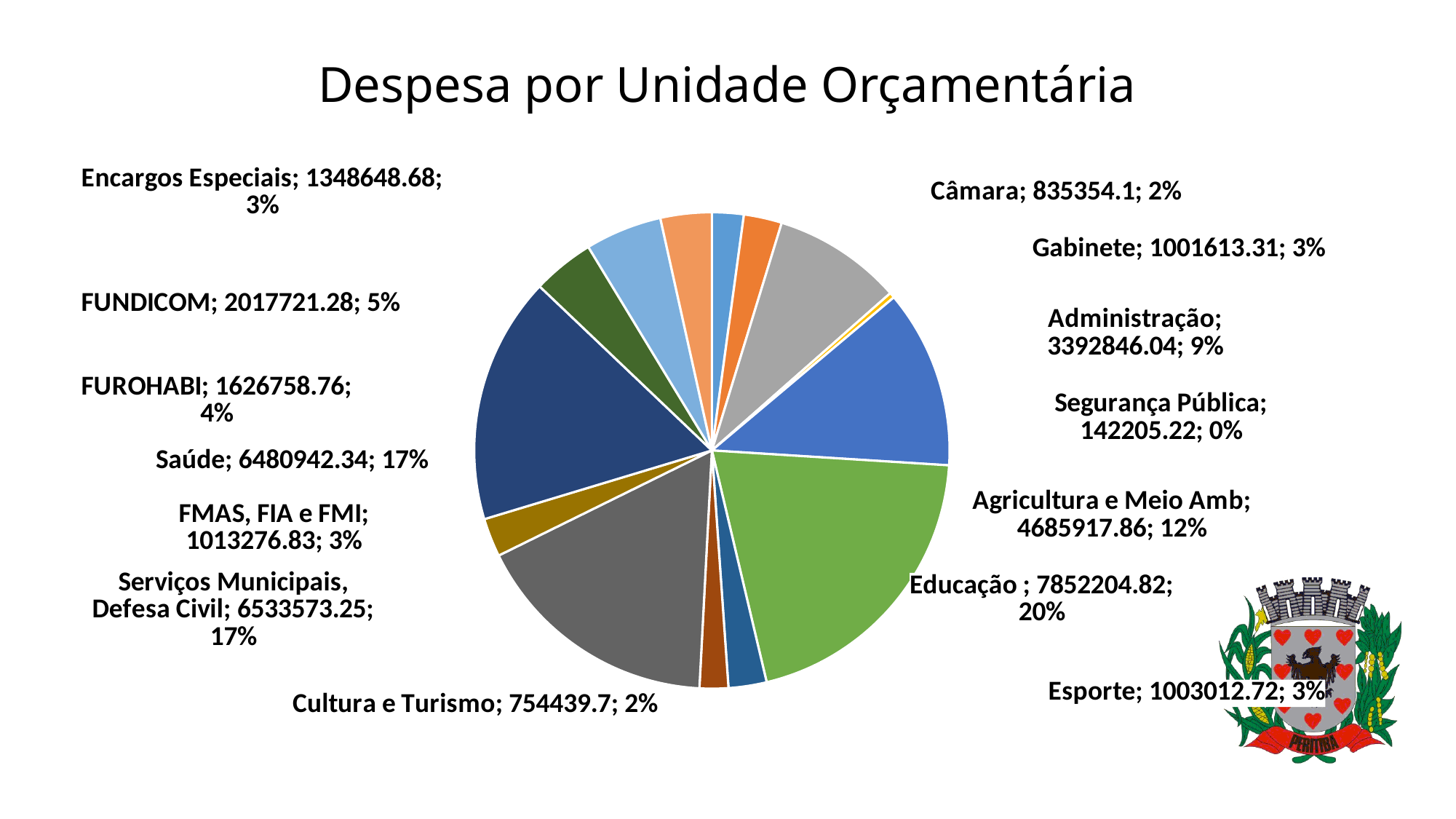
What is the value shown for Educação? 7852204.82 What kind of chart is shown on the slide? pie chart What is the value shown for Administração? 3392846.04 Which is larger, the value for Administração or the value for Agricultura e Meio Amb? Agricultura e Meio Amb What is the title of the chart? Despesa por Unidade Orçamentária What is the value shown for Segurança Pública? 142205.22 How many categories (slices) does the pie chart have? 14 Which category has the largest share of the pie? Educação Which category has the smallest value? Segurança Pública What is the difference between the values for Educação and Saúde? 1371262.48 What percentage share of the pie does Saúde have? 17% What percentage share of the pie does Agricultura e Meio Amb have? 12%